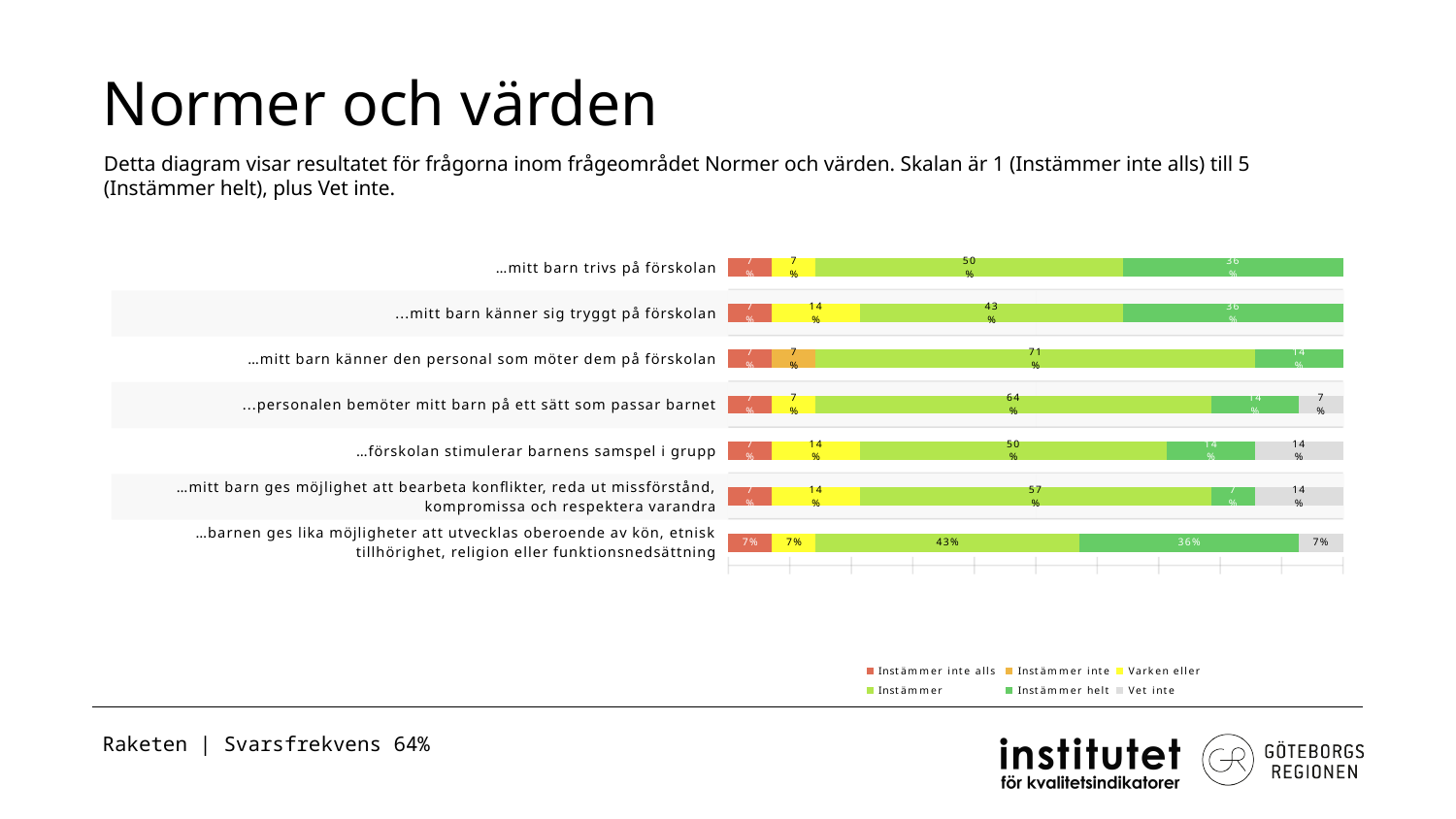
How many series does the chart legend list? 6 How many statements (bars) are shown in the chart? 7 Which legend entry is shown in grey? Vet inte Which statement has the lowest 'Instämmer helt' share? …mitt barn ges möjlighet att bearbeta konflikter, reda ut missförstånd, kompromissa och respektera varandra What is the 'Vet inte' share for '…förskolan stimulerar barnens samspel i grupp'? 14% What is the 'Instämmer' share for '…mitt barn känner den personal som möter dem på förskolan'? 71% How much larger is the 'Instämmer' share for '…personalen bemöter mitt barn på ett sätt som passar barnet' than for '…mitt barn känner sig tryggt på förskolan'? 21 percentage points Which has the larger 'Instämmer helt' share: '…mitt barn trivs på förskolan' or '…personalen bemöter mitt barn på ett sätt som passar barnet'? …mitt barn trivs på förskolan What is the 'Instämmer helt' share for '…mitt barn trivs på förskolan'? 36% What is the 'Instämmer' share for '…barnen ges lika möjligheter att utvecklas oberoende av kön, etnisk tillhörighet, religion eller funktionsnedsättning'? 43% What kind of chart is shown on the slide? Stacked bar chart Which statement has the highest 'Instämmer' share? …mitt barn känner den personal som möter dem på förskolan